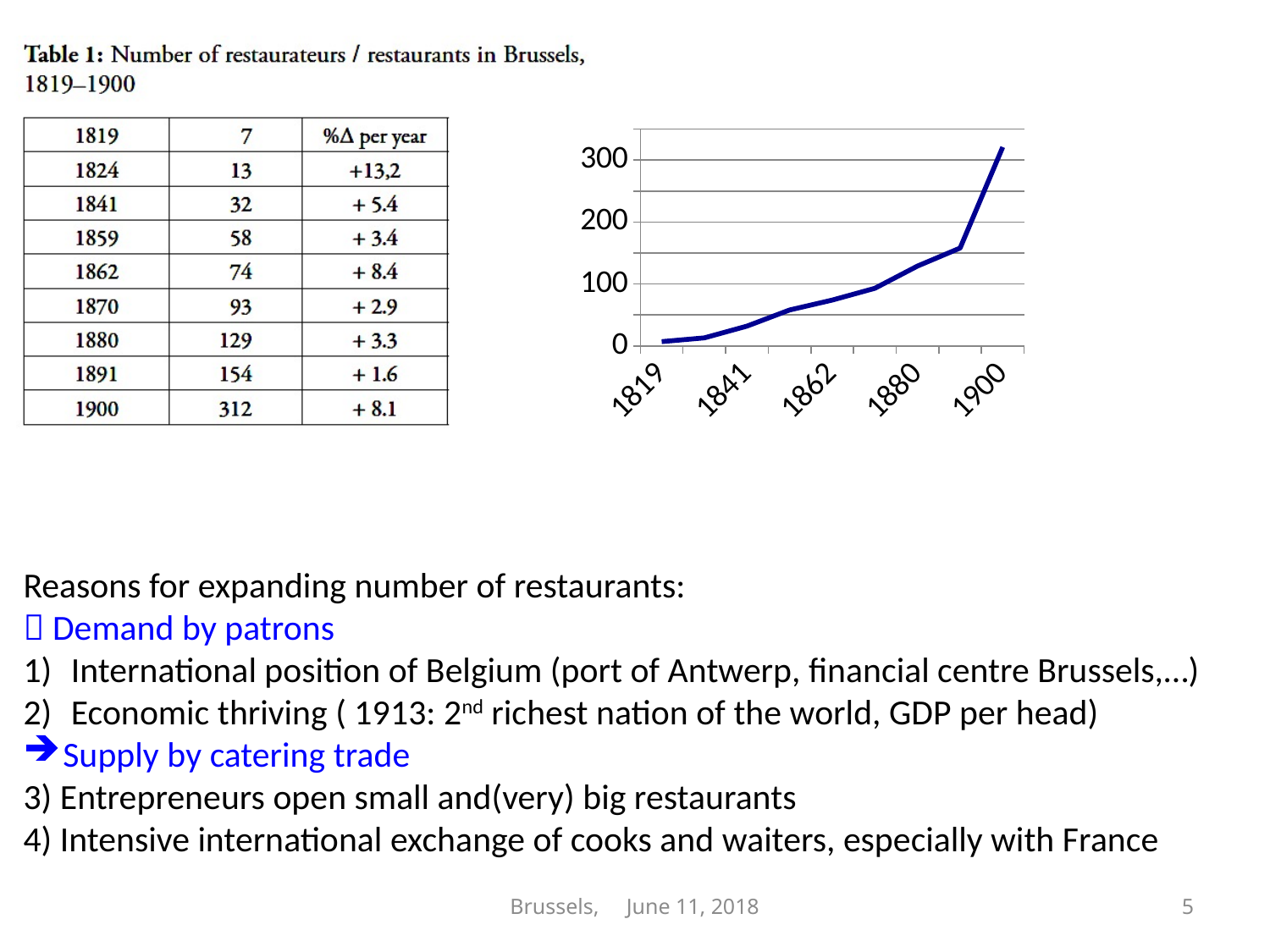
Which year has the highest number of restaurants in the chart? 1900 Do the values in the line chart rise or fall from 1819 to 1900? rise According to Table 1, what is the %Δ per year value for 1824? +13,2 Which year has the lowest number of restaurants in the chart? 1819 According to Table 1, how many restaurants were there in Brussels in 1862? 74 In the line chart, is the value for 1900 greater or less than 300? greater In the line chart, is the value for 1880 greater or less than 100? greater What kind of chart is shown on the slide? line chart What is the title of Table 1 on the slide? Number of restaurateurs / restaurants in Brussels, 1819–1900 Using the values in Table 1, what is the difference in the number of restaurants between 1900 and 1891? 158 According to Table 1, how many restaurants were there in Brussels in 1900? 312 In the line chart, is the value for 1841 greater or less than 100? less